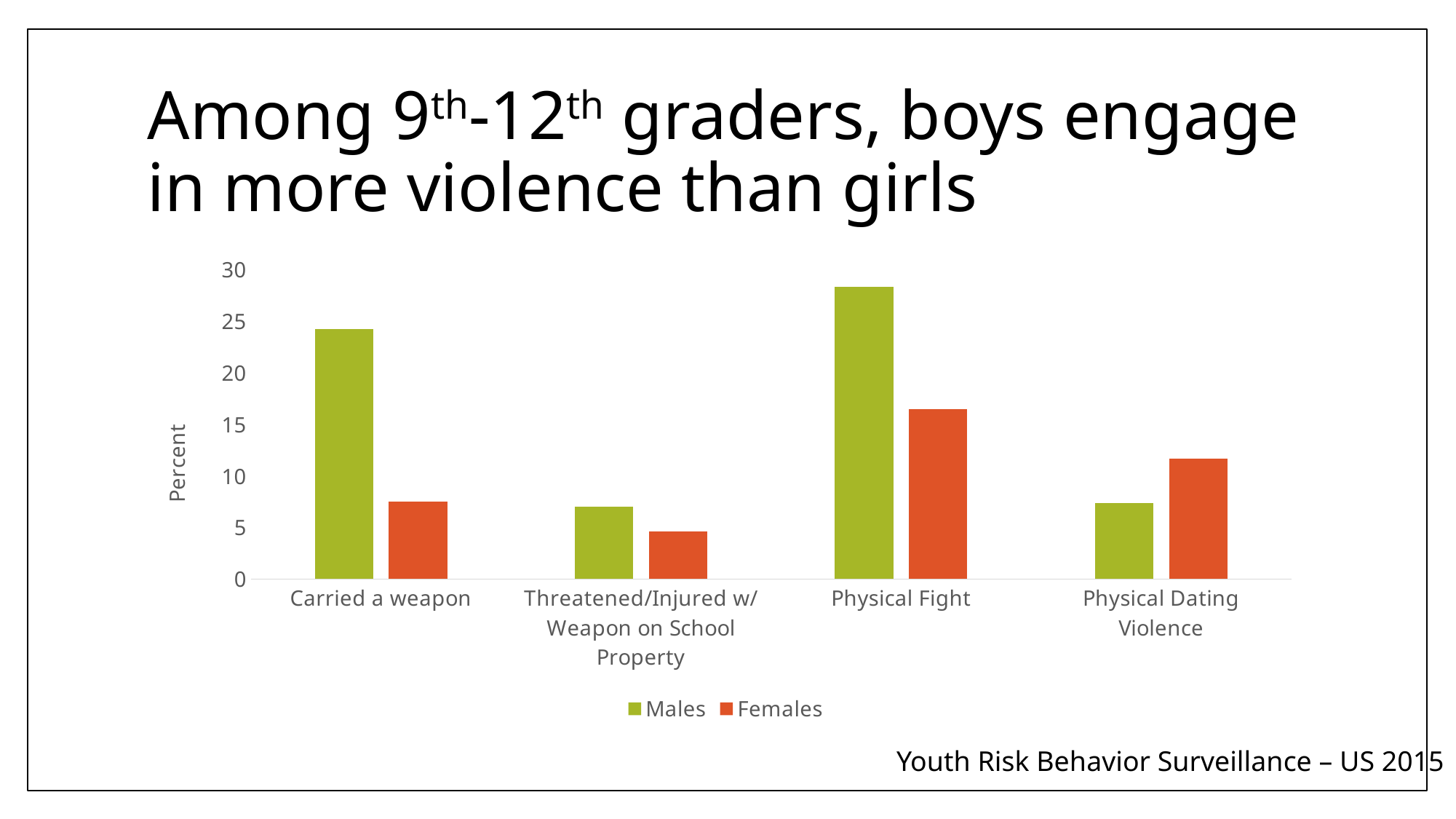
Is the value for Females in Carried a weapon greater or less than 10? less How many series does the chart's legend list? 2 Which category has the highest value for Females? Physical Fight What is the label on the chart's vertical axis? Percent For Carried a weapon, which is larger: the value for Males or the value for Females? Males Which category has the lowest value for Females? Threatened/Injured w/ Weapon on School Property For Physical Dating Violence, which is larger: the value for Males or the value for Females? Females Is the value for Males in Physical Fight greater or less than 25? greater What kind of chart is shown on the slide? bar chart Which category has the highest value for Males? Physical Fight Is the value for Females in Physical Dating Violence greater or less than 10? greater How many categories are shown on the x axis of the chart? 4